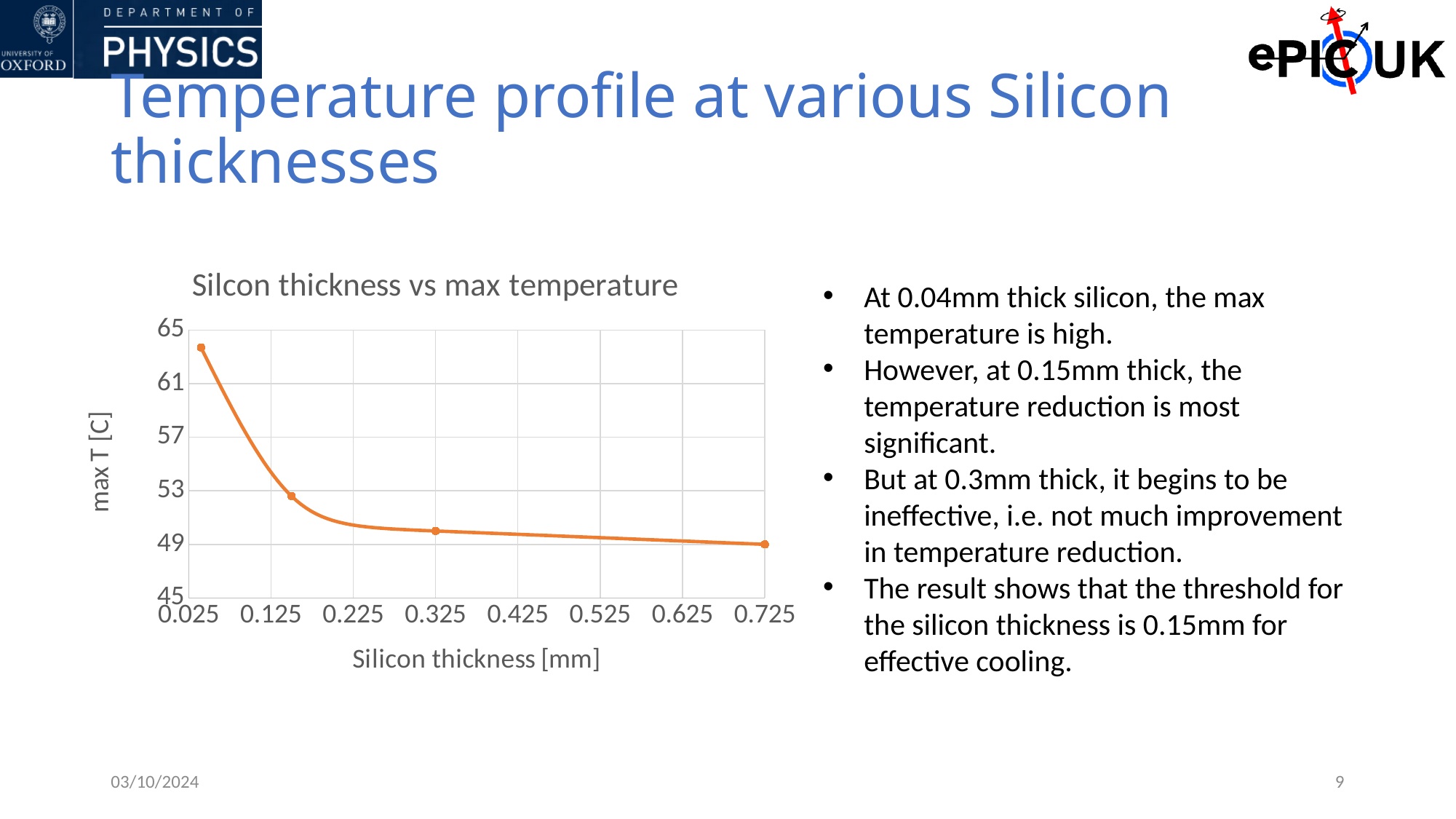
At which silicon thickness is the max temperature highest: the smallest thickness plotted or the largest? the smallest thickness Is the max temperature for the second data point (near 0.15 mm) greater or less than 49? greater What is the label of the y axis of the chart? max T [C] Is the max temperature for the leftmost data point (thinnest silicon) greater or less than 61? greater What is the title of the chart? Silcon thickness vs max temperature What kind of chart is shown on the slide? line chart Is the max temperature for the third data point (near 0.325 mm) greater or less than 53? less Does the max temperature rise or fall as silicon thickness increases along the x axis? fall Which data point has the highest max temperature: the leftmost (thinnest silicon) or the rightmost (thickest silicon)? the leftmost (thinnest silicon) How many data points are plotted on the chart? 4